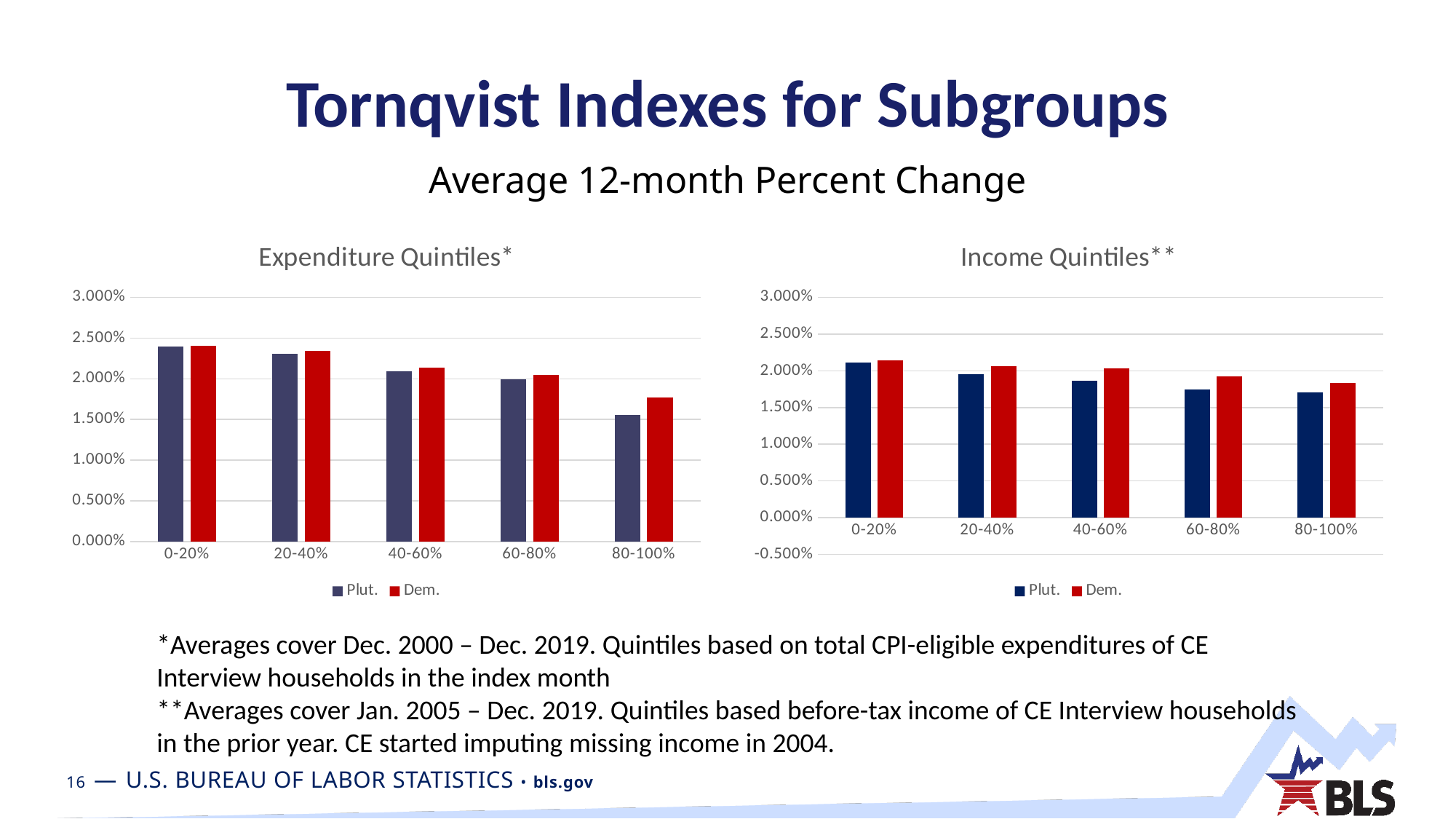
In the Expenditure Quintiles chart, is the Plut. value for the 80-100% quintile greater or less than 2.000%? less How many series does the legend of the Expenditure Quintiles chart list? 2 In the Income Quintiles chart, which quintile has the highest Dem. value? 0-20% In the Income Quintiles chart, is the Plut. value for the 80-100% quintile greater or less than 2.000%? less What are the two legend entries in the Income Quintiles chart? Plut. and Dem. In the Income Quintiles chart, is the Plut. value for the 0-20% quintile greater or less than 2.000%? greater How many quintile categories are shown on the x axis of the Income Quintiles chart? 5 In the Expenditure Quintiles chart, which quintile has the lowest Plut. value? 80-100% In the Expenditure Quintiles chart, do the Plut. values rise or fall from the 0-20% quintile to the 80-100% quintile? fall In the Expenditure Quintiles chart, which series has the larger value for the 80-100% quintile, Plut. or Dem.? Dem. What kind of chart is the Expenditure Quintiles chart? bar chart